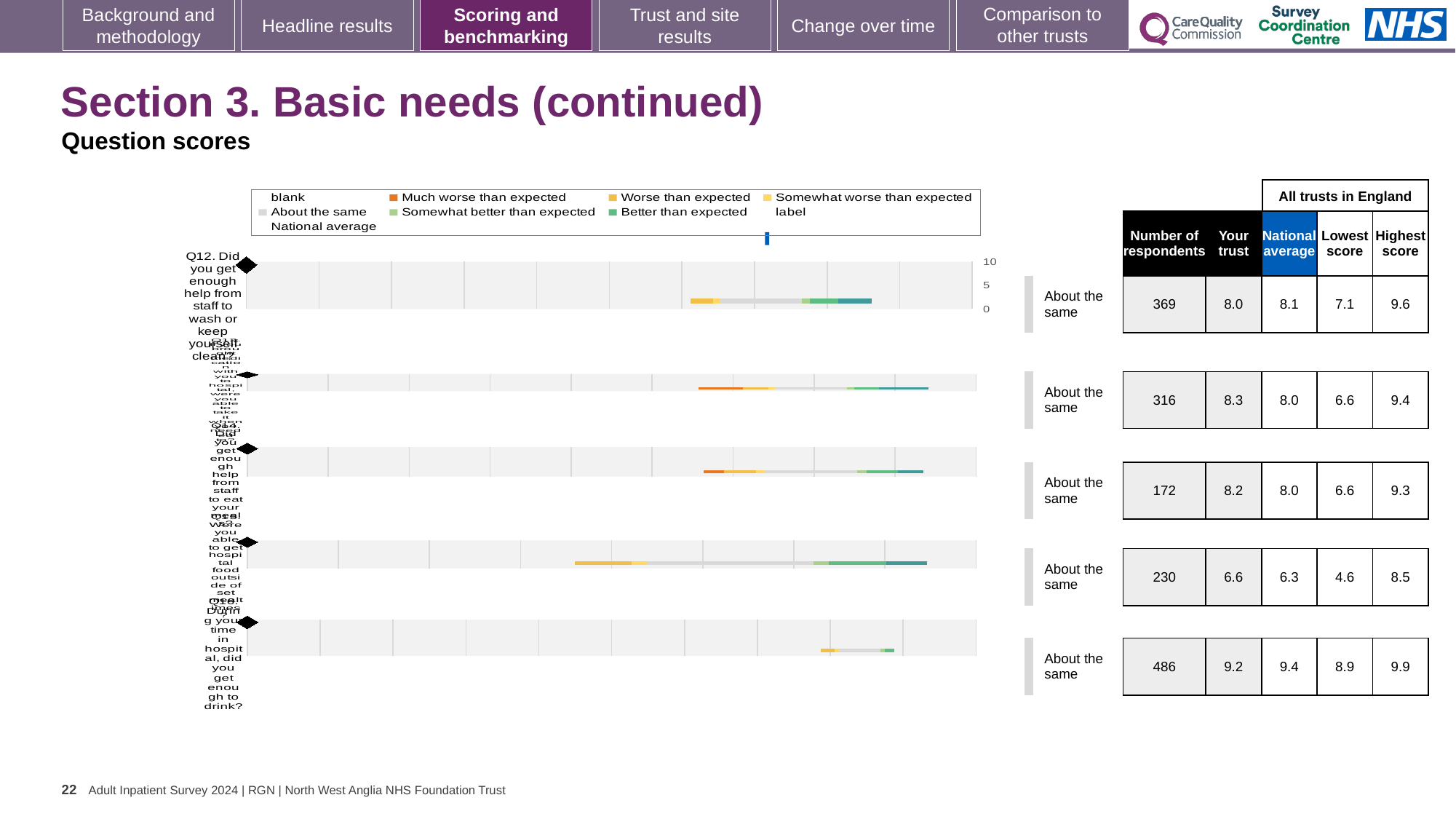
Which bar row has the highest 'Your trust' score? the fifth (bottom) row, 9.2 How many question rows (bars) are plotted in the chart? 5 What kind of chart is shown on the slide? bar chart For Q12 (the first bar, about getting enough help from staff to wash or keep yourself clean), what is the 'Your trust' score? 8.0 For Q12 (the first bar), how many respondents are there? 369 Which colour does the legend use for 'Much worse than expected'? orange For Q12 (the first bar), what is the national average score? 8.1 What is the benchmark category shown next to every bar in the chart? About the same Which bar row has the lowest 'Your trust' score? the fourth row, 6.6 For the fifth (bottom) bar row, what is the highest score among all trusts in England? 9.9 What is the difference between the highest 'Your trust' score (9.2) and the lowest 'Your trust' score (6.6)? 2.6 For the second bar row, which is larger: the 'Your trust' score or the national average? Your trust (8.3)